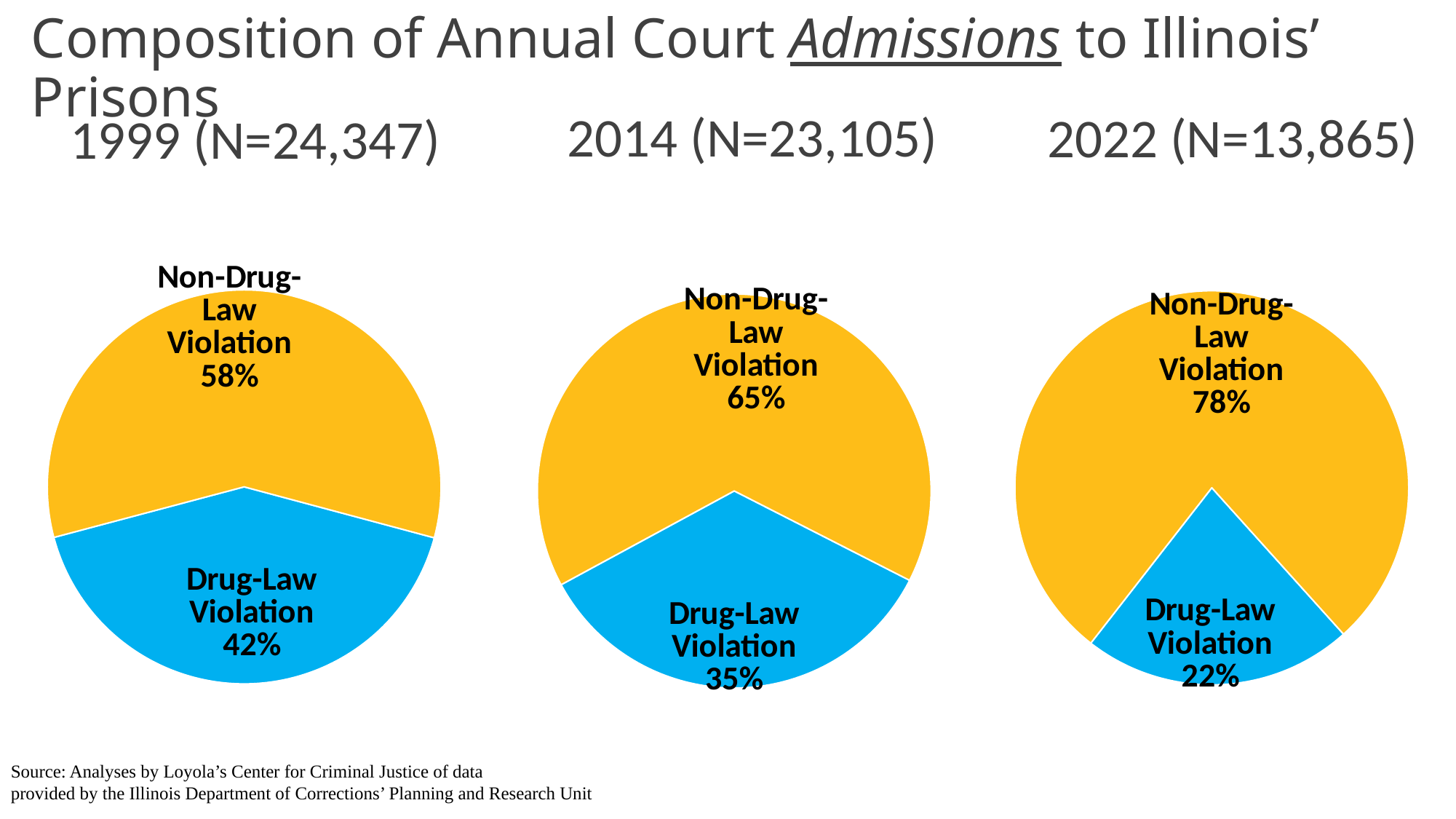
In the 2022 (N=13,865) pie chart, what share of admissions is Drug-Law Violation? 22% How many slices does the 2014 (N=23,105) pie chart have? 2 Across the three pie charts from 1999 to 2022, does the Drug-Law Violation share rise or fall? Fall What colour is the Drug-Law Violation slice in the 2022 (N=13,865) pie chart? Blue In the 1999 (N=24,347) pie chart, what share of admissions is Drug-Law Violation? 42% In the 2014 (N=23,105) pie chart, what share of admissions is Non-Drug-Law Violation? 65% In the 2014 (N=23,105) pie chart, which slice is the smallest? Drug-Law Violation In the 1999 (N=24,347) pie chart, what is the value for Non-Drug-Law Violation? 58% Is the Drug-Law Violation share larger in the 1999 (N=24,347) pie chart or the 2014 (N=23,105) pie chart? 1999 (N=24,347) In the 2022 (N=13,865) pie chart, what is the difference between the Non-Drug-Law Violation and Drug-Law Violation shares? 56% In the 2022 (N=13,865) pie chart, which slice is the largest? Non-Drug-Law Violation What kind of chart is used to show the 1999 (N=24,347) data? Pie chart